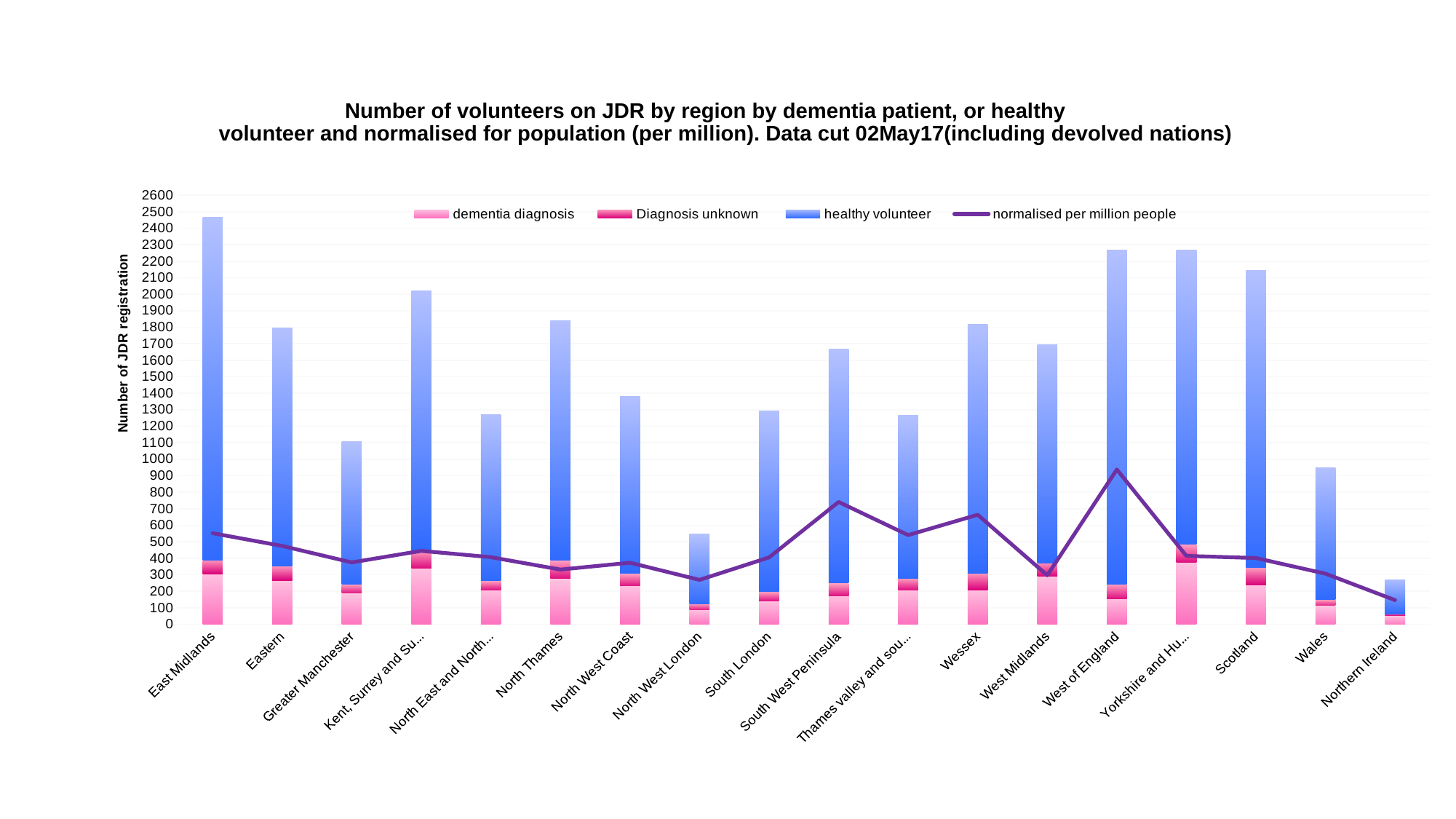
Which series is shown as a purple line rather than as bars? normalised per million people Which region has the highest value on the 'normalised per million people' line? West of England Which region has the highest total number of JDR registrations? East Midlands Is the total number of JDR registrations for East Midlands greater or less than 2400? greater Is the 'normalised per million people' value for West of England greater or less than 800? greater Is the total number of JDR registrations for Wales greater or less than 1000? less How many series does the legend list? 4 Which region has the larger total number of JDR registrations, Scotland or Eastern? Scotland Which region has the lowest total number of JDR registrations? Northern Ireland Which region has the lowest value on the 'normalised per million people' line? Northern Ireland How many regions are shown along the x axis? 18 What kind of chart is shown on the slide? A stacked bar chart with a line overlay